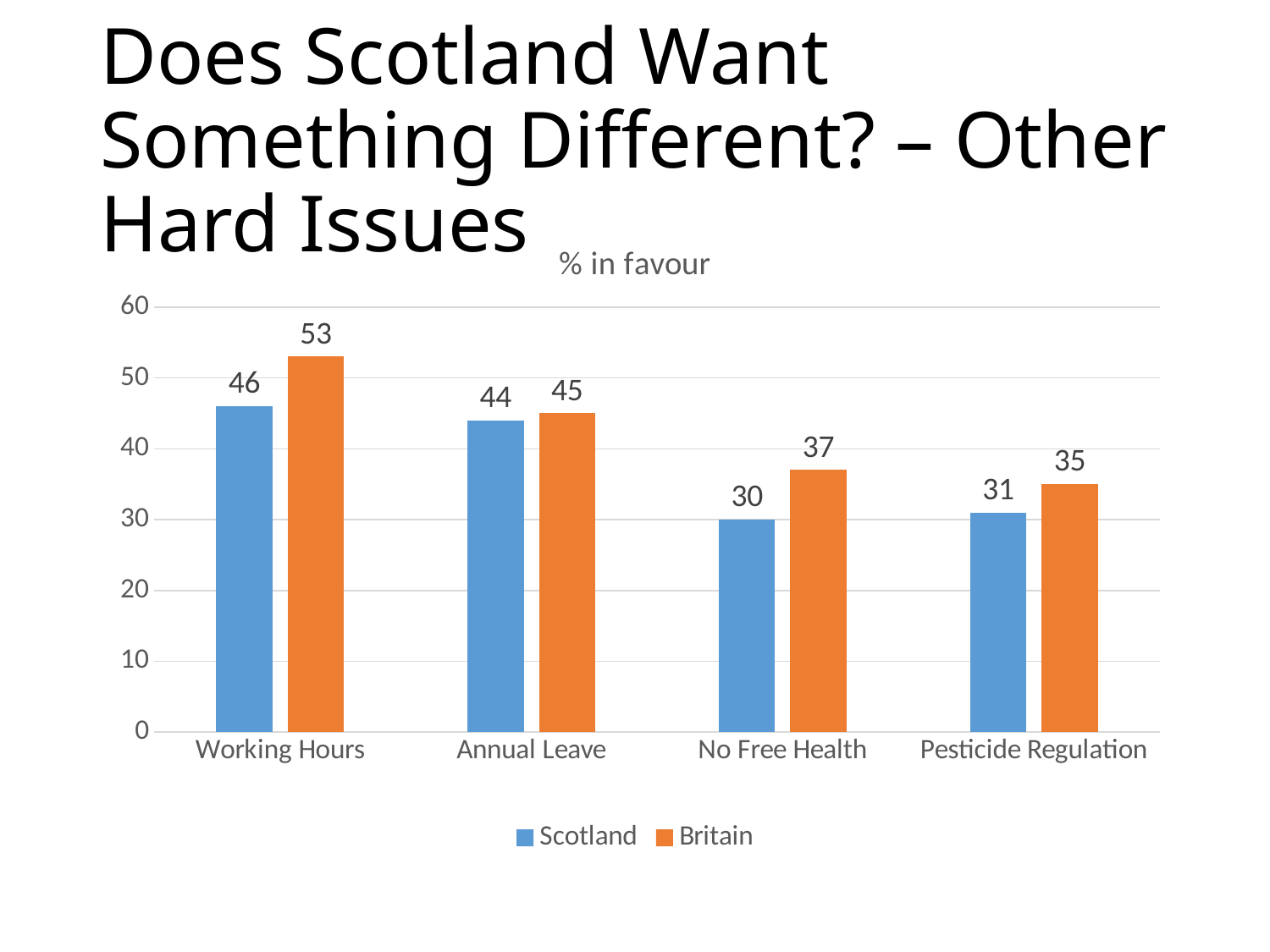
Which category has the lowest value for Scotland? No Free Health Which is larger on Annual Leave, Scotland or Britain? Britain What is the value for Scotland on Working Hours? 46 How many series does the legend list? 2 What is the difference between Britain and Scotland on Working Hours? 7 What is the value for Scotland on Pesticide Regulation? 31 What kind of chart is shown on the slide? Bar chart What is the title of the chart? % in favour How many categories are shown on the x axis? 4 Which category has the highest value for Britain? Working Hours What is the difference between Britain and Scotland on No Free Health? 7 What is the value for Britain on No Free Health? 37